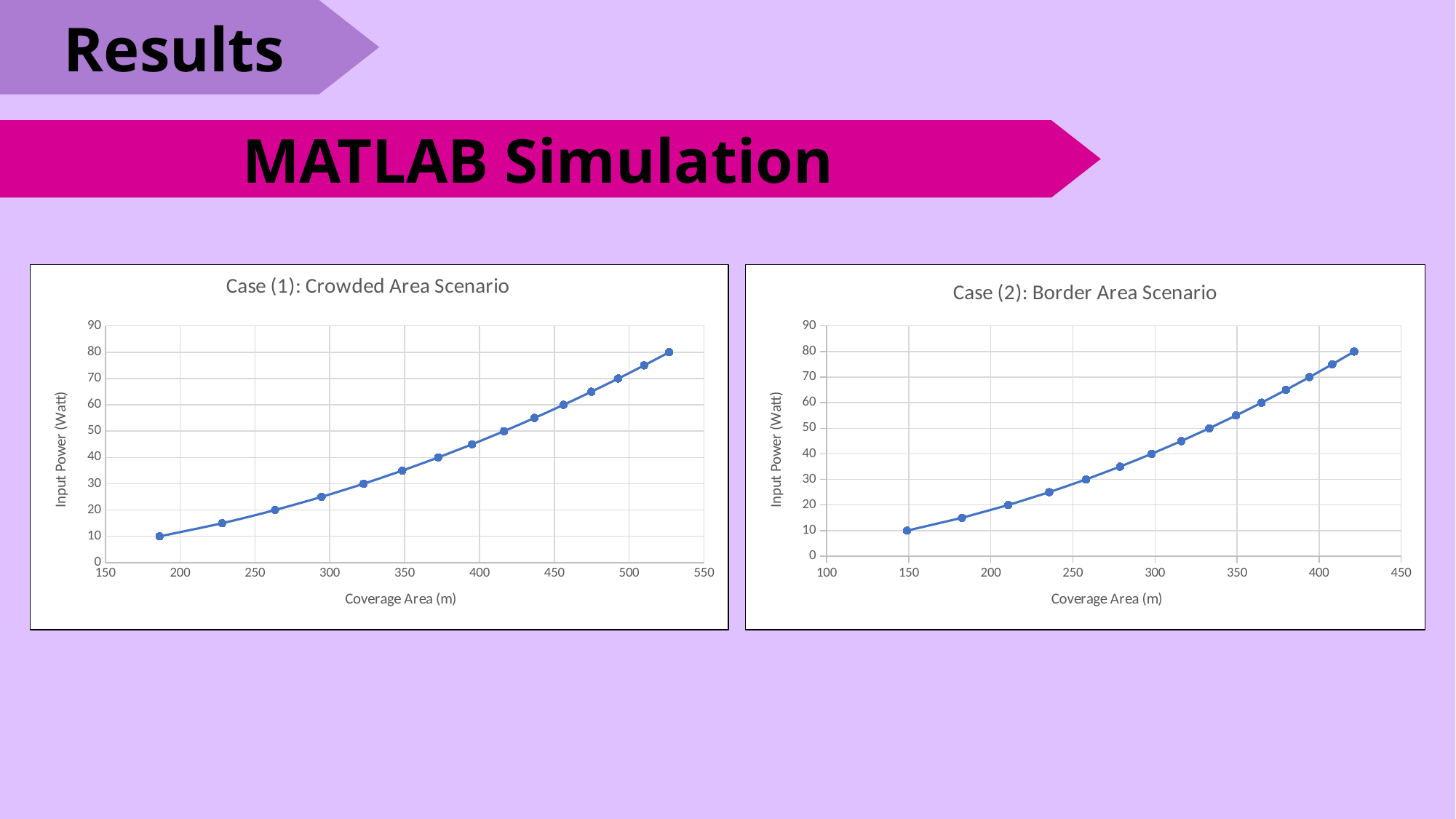
What kind of chart is 'Case (1): Crowded Area Scenario'? line chart In 'Case (1): Crowded Area Scenario', is the input power of the rightmost point greater or less than 70? greater In 'Case (2): Border Area Scenario', what is the lowest input power value plotted? 10 In 'Case (1): Crowded Area Scenario', does the input power rise or fall as the coverage area increases? rises How many data points are plotted in 'Case (2): Border Area Scenario'? 15 What is the label of the y axis in 'Case (2): Border Area Scenario'? Input Power (Watt) What is the label of the x axis in 'Case (1): Crowded Area Scenario'? Coverage Area (m) In 'Case (1): Crowded Area Scenario', is the input power at a coverage area of about 400 m greater or less than 40? greater In 'Case (2): Border Area Scenario', does the input power rise or fall as the coverage area increases? rises How many data points are plotted in 'Case (1): Crowded Area Scenario'? 15 In 'Case (1): Crowded Area Scenario', what is the highest input power value plotted? 80 In 'Case (2): Border Area Scenario', is the input power of the leftmost point greater or less than 20? less